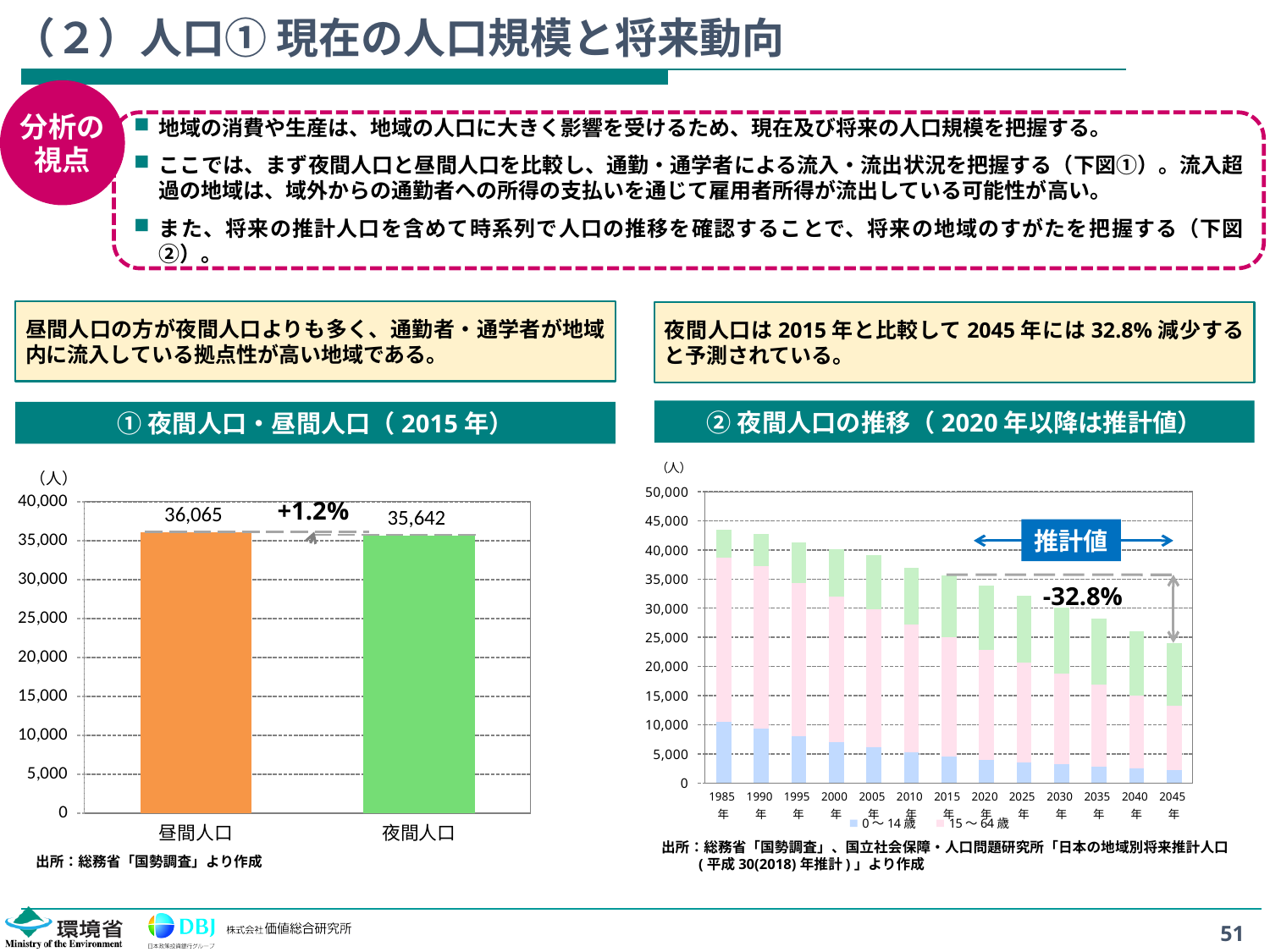
In chart ① 夜間人口・昼間人口（2015年）, what is the value for 夜間人口? 35,642 In chart ② 夜間人口の推移, which year has the lowest total value? 2045年 In chart ① 夜間人口・昼間人口（2015年）, what percentage is annotated between the two bars? +1.2% How many categories are shown in chart ① 夜間人口・昼間人口（2015年）? 2 How many years are shown on the x axis of chart ② 夜間人口の推移? 13 What kind of chart is chart ① 夜間人口・昼間人口（2015年）? bar chart In chart ② 夜間人口の推移, is the total value for 1985年 greater or less than 40,000? greater In chart ① 夜間人口・昼間人口（2015年）, what is the difference between 昼間人口 and 夜間人口? 423 In chart ② 夜間人口の推移, do the total values rise or fall from 1985 to 2045? fall In chart ① 夜間人口・昼間人口（2015年）, what is the value for 昼間人口? 36,065 In chart ① 夜間人口・昼間人口（2015年）, which is larger, 昼間人口 or 夜間人口? 昼間人口 In chart ② 夜間人口の推移, is the total value for 2045年 greater or less than 30,000? less